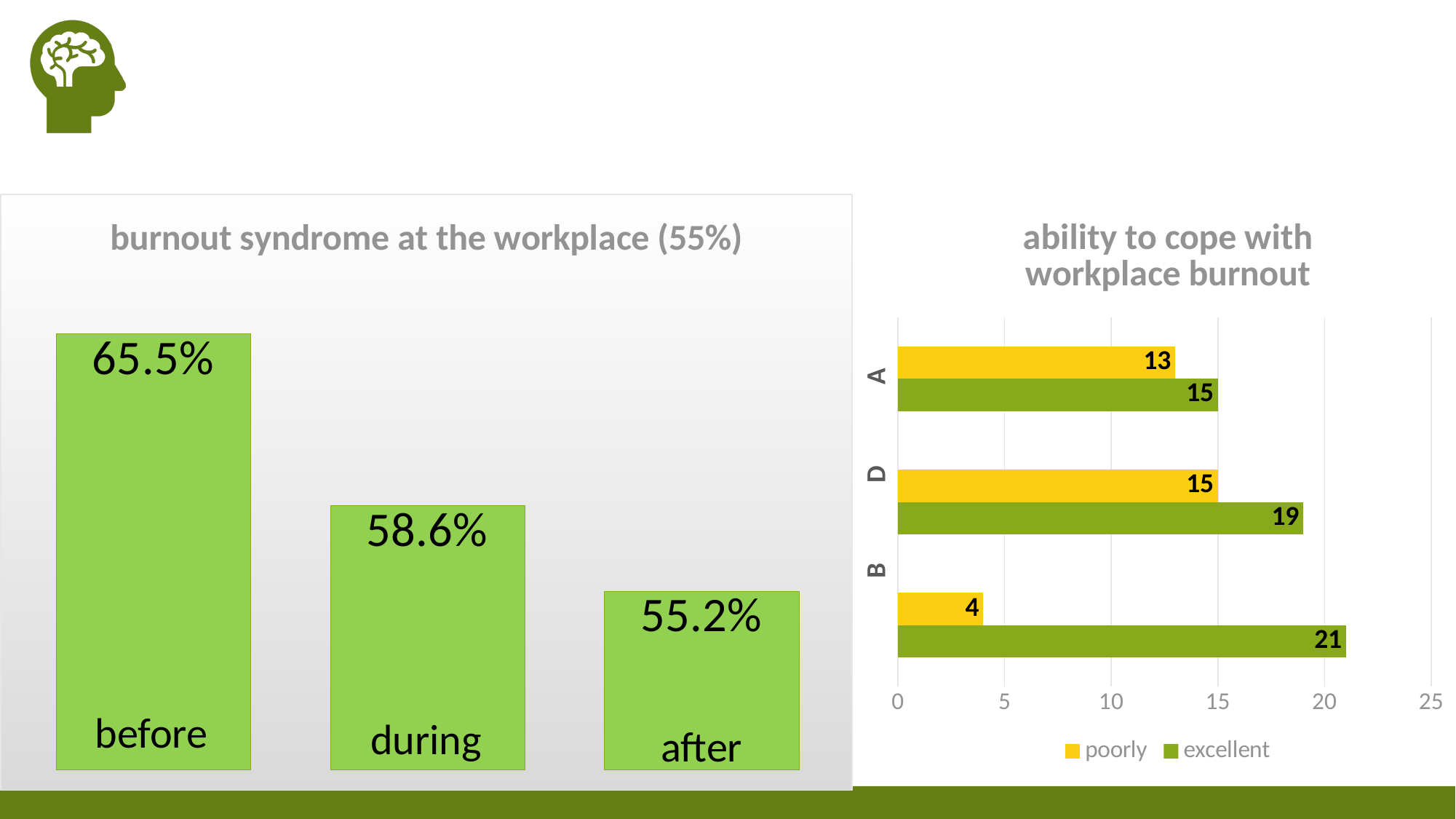
In the 'burnout syndrome at the workplace (55%)' chart, do the values rise or fall from 'before' to 'after'? fall In the 'ability to cope with workplace burnout' chart, what is the difference between the 'excellent' and 'poorly' values for category B? 17 In the 'burnout syndrome at the workplace (55%)' chart, what is the value for 'before'? 65.5% In the 'ability to cope with workplace burnout' chart, which is larger for category A: 'poorly' or 'excellent'? excellent In the 'burnout syndrome at the workplace (55%)' chart, what is the value for 'after'? 55.2% In the 'ability to cope with workplace burnout' chart, which category has the lowest 'poorly' value? B In the 'burnout syndrome at the workplace (55%)' chart, which category has the lowest value? after In the 'burnout syndrome at the workplace (55%)' chart, how many categories are shown? 3 In the 'ability to cope with workplace burnout' chart, what is the 'poorly' value for category D? 15 In the 'ability to cope with workplace burnout' chart, what is the 'excellent' value for category B? 21 How many series does the legend of the 'ability to cope with workplace burnout' chart list? 2 What kind of chart is the 'ability to cope with workplace burnout' chart? bar chart